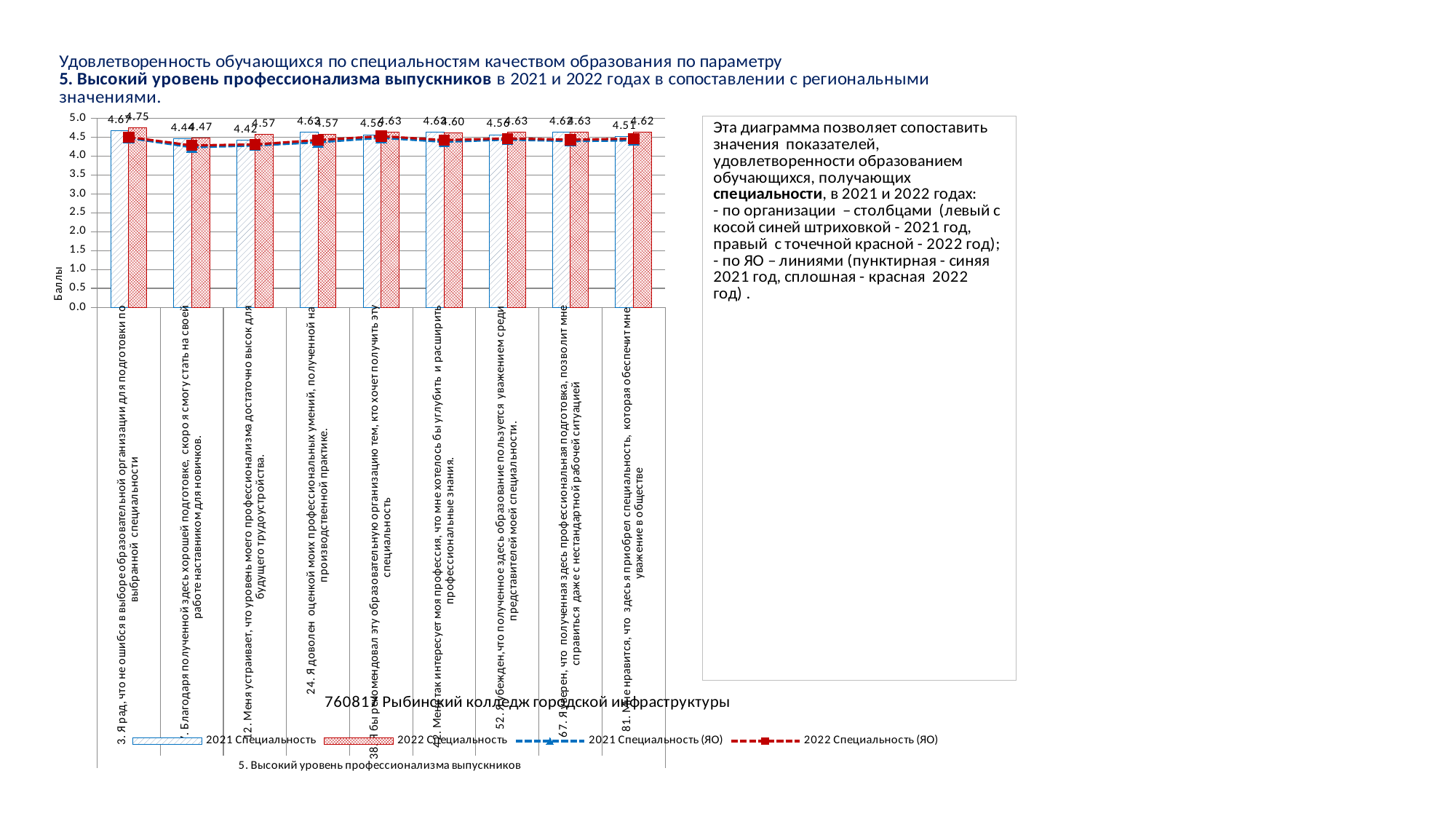
What is the title of the vertical axis of the chart? Баллы Which item has the lowest 2021 Специальность value? Меня устраивает, что уровень моего профессионализма достаточно высок для будущего трудоустройства What is the 2021 Специальность value for item 81 ("Мне нравится, что здесь я приобрел специальность...")? 4.51 What is the 2022 Специальность value for item 3 ("Я рад, что не ошибся в выборе образовательной организации...")? 4.75 What is the 2021 Специальность value for item 3 ("Я рад, что не ошибся в выборе образовательной организации...")? 4.67 What is the 2022 Специальность value for item 24 ("Я доволен оценкой моих профессиональных умений...")? 4.57 For item 24 ("Я доволен оценкой моих профессиональных умений..."), which is larger: the 2021 Специальность value or the 2022 Специальность value? 2021 Специальность How many series does the chart legend list? 4 What is the difference between the 2022 and 2021 Специальность values for item 81 ("Мне нравится, что здесь я приобрел специальность...")? 0.11 Which item has the highest 2022 Специальность value? 3. Я рад, что не ошибся в выборе образовательной организации для подготовки по выбранной специальности How many items (categories) are shown on the x axis of the chart? 9